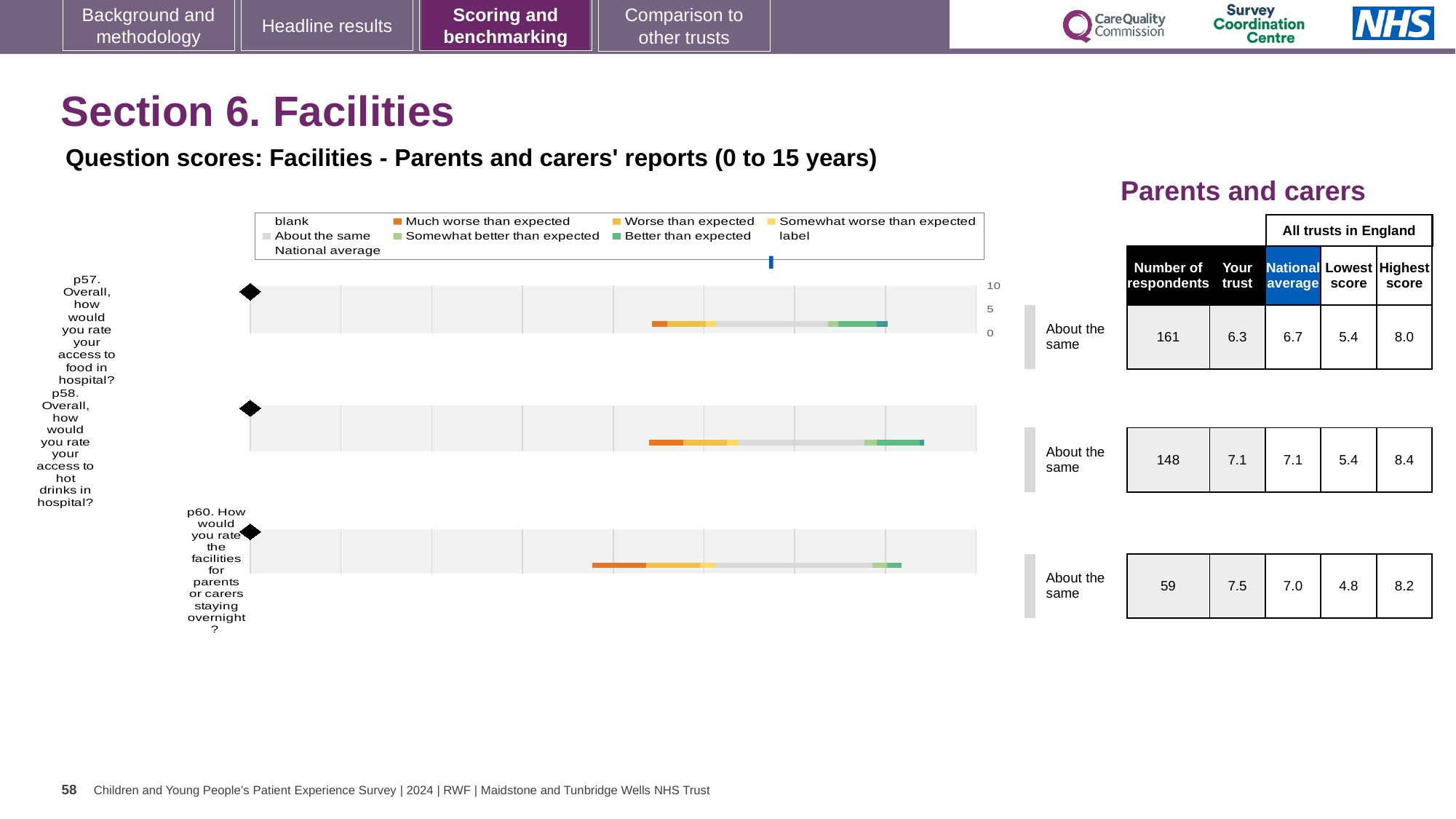
What is the 'Your trust' score for p57 (access to food in hospital)? 6.3 Is the 'Your trust' score for p57 greater or less than 5 on the chart axis? greater How many questions (categories) are plotted in the Facilities question scores chart? 3 What benchmark category is shown for all three questions on this slide? About the same What kind of chart is used to show the question scores for p57, p58 and p60? bar chart Which question has the highest 'Your trust' score? p60 What is the national average score for p58 (access to hot drinks in hospital)? 7.1 How many respondents answered p60 (facilities for parents or carers staying overnight)? 59 What is the difference between the highest score and the lowest score for p57? 2.6 Which has the larger 'Your trust' score, p57 or p58? p58 What is the highest score across all trusts in England for p57? 8.0 Which question has the lowest number of respondents? p60